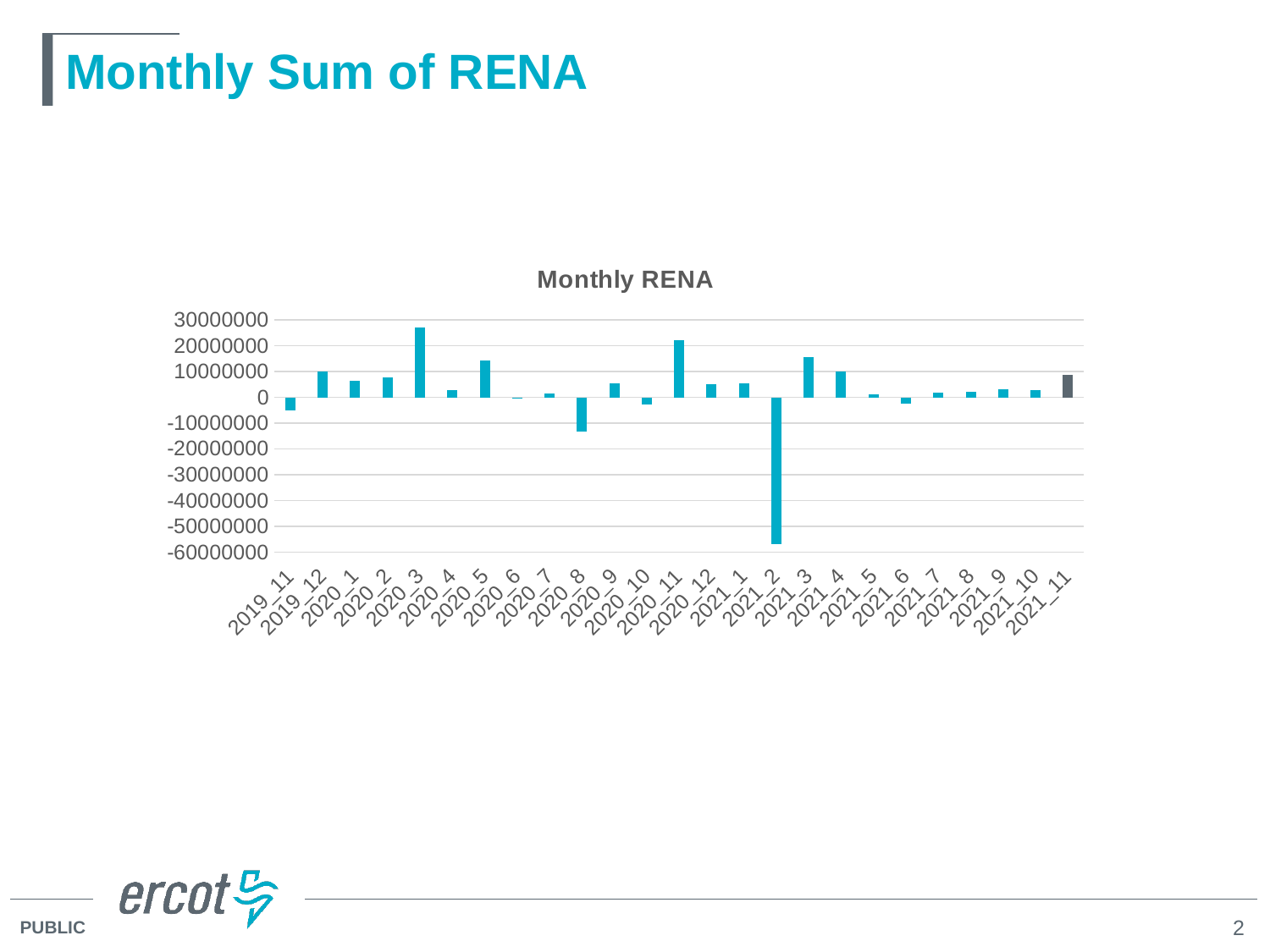
Is the value for 2021_3 greater or less than 10000000? greater What is the title of the chart? Monthly RENA Which bar is drawn in a different colour (dark grey) from the rest? 2021_11 What kind of chart is shown on the slide? bar chart Which is larger, the value for 2020_3 or the value for 2020_11? 2020_3 Which month has the lowest Monthly RENA value? 2021_2 Which month has the highest Monthly RENA value? 2020_3 Is the value for 2021_2 greater or less than -50000000? less Is the value for 2020_3 greater or less than 20000000? greater How many monthly categories are plotted on the x axis? 25